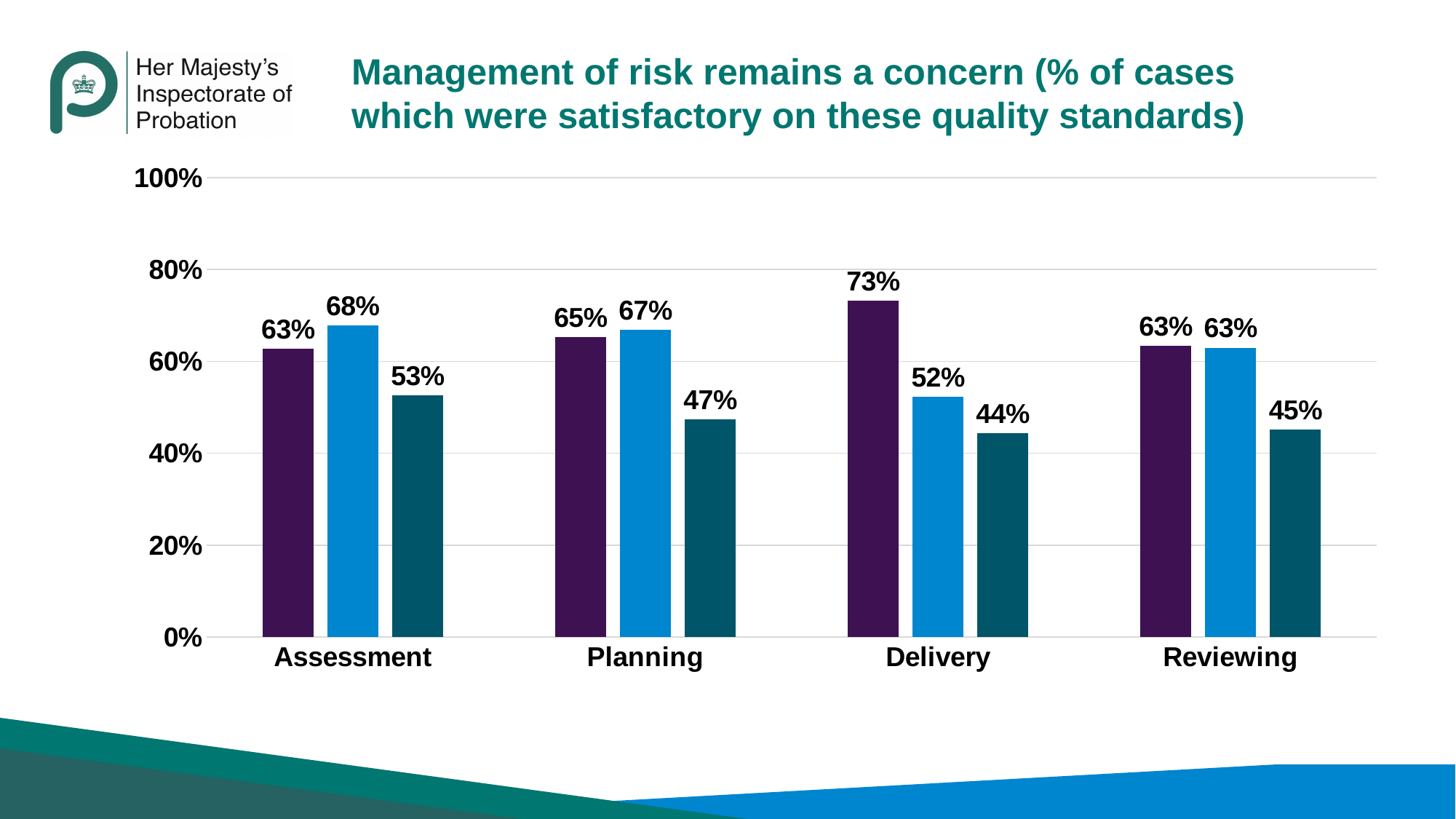
Which category has the highest value for the dark purple (first) bar? Delivery Is the value of the dark teal (third) bar for Reviewing greater or less than 60%? less What type of chart is shown on the slide? bar chart Which is larger for Planning: the dark purple bar or the dark teal bar? the dark purple bar What is the value of the light blue (second) bar for Assessment? 68% How many categories are shown on the x axis of the chart? 4 What is the difference between the dark purple bar and the dark teal bar for Delivery? 29% What is the title of the chart on the slide? Management of risk remains a concern (% of cases which were satisfactory on these quality standards) What is the difference between the light blue bar and the dark teal bar for Reviewing? 18% What is the value of the dark teal (third) bar for Planning? 47% What is the value of the dark purple (first) bar for Delivery? 73% Which category has the lowest value for the dark teal (third) bar? Delivery